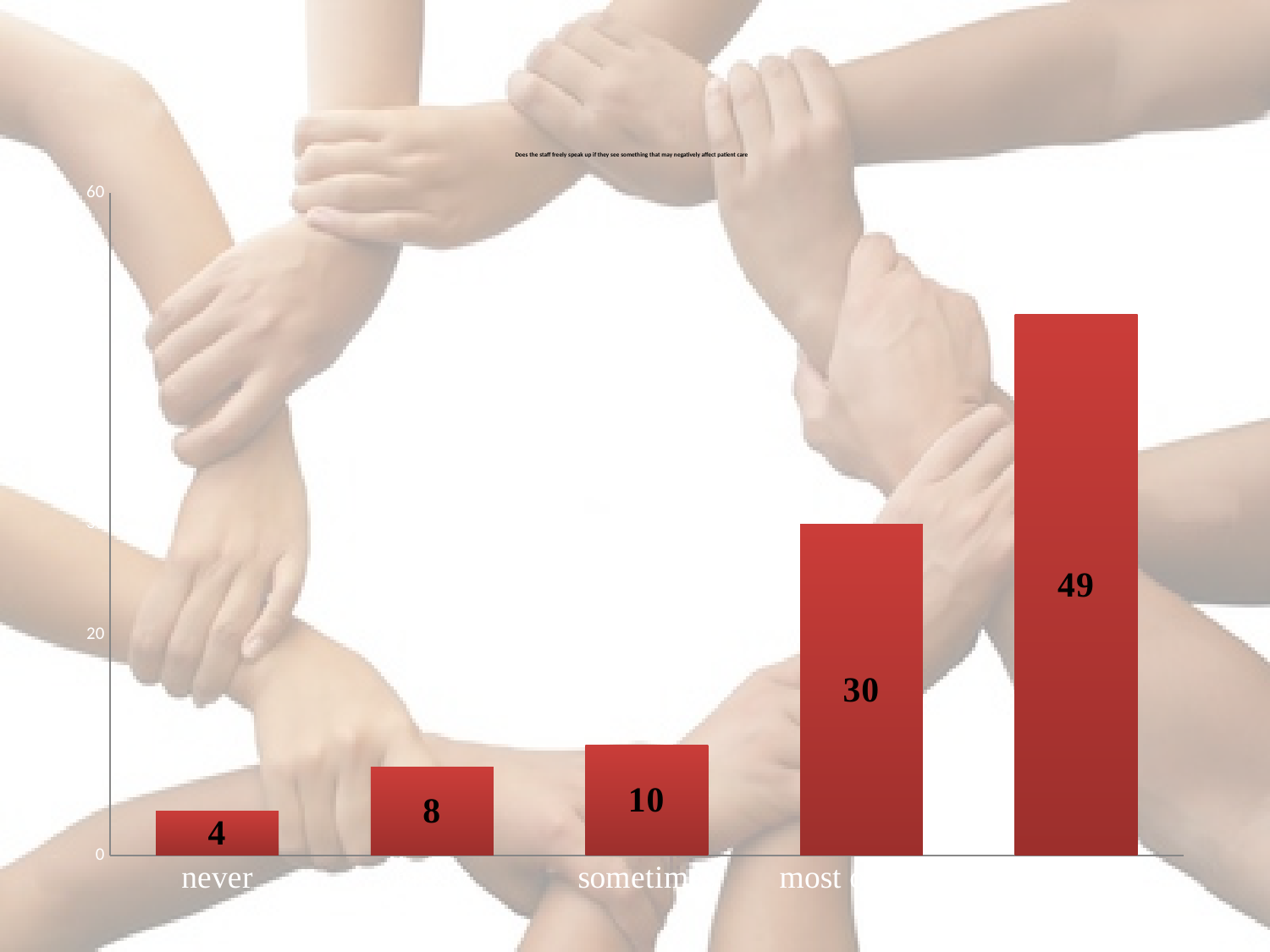
What is the difference between the value for "sometimes" and the value for "never"? 6 How many bars are plotted in the chart? 5 Do the bar values rise or fall from left to right along the x axis? rise What is the value for "sometimes"? 10 What is the value shown on the tallest bar? 49 What is the value for "never"? 4 What kind of chart is shown on the slide? bar chart Which is larger, the value for "sometimes" or the value for "never"? sometimes Is the value for "sometimes" greater or less than 20? less What is the difference between the tallest bar and the second-tallest bar? 19 Which category has the lowest value? never Is the value of the tallest bar greater or less than 40? greater